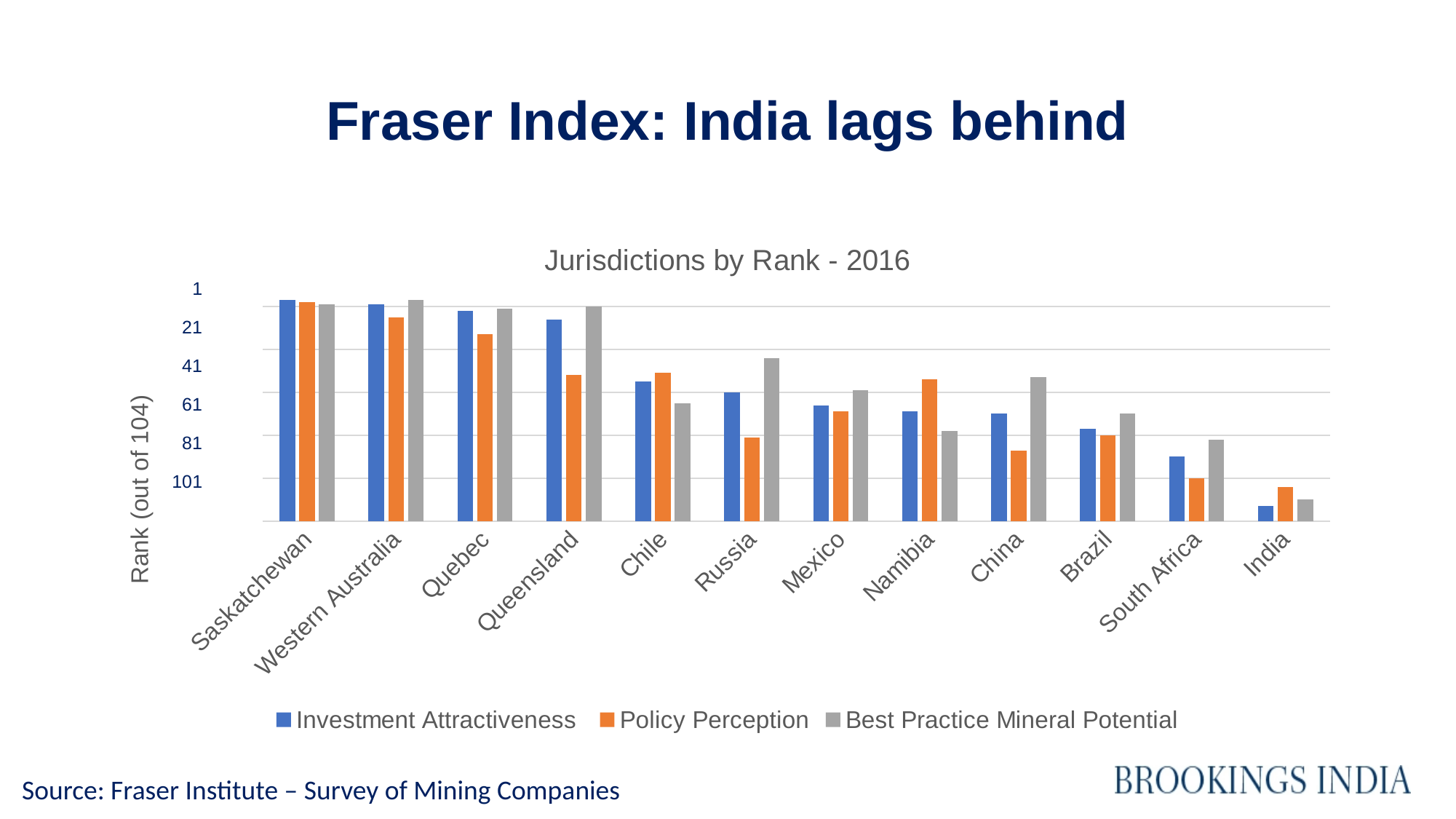
What kind of chart is shown on the slide? Bar chart Which jurisdiction has the worst (highest-numbered) Investment Attractiveness rank? India What is the title of the chart? Jurisdictions by Rank - 2016 Which jurisdiction has the best (lowest-numbered) Investment Attractiveness rank? Saskatchewan For Russia, which has the better (lower-numbered) rank: Policy Perception or Best Practice Mineral Potential? Best Practice Mineral Potential Is the Investment Attractiveness rank for India greater or less than 81? greater How many series does the chart's legend list? 3 Which jurisdiction has the worst (highest-numbered) Best Practice Mineral Potential rank? India Is the Investment Attractiveness rank for Saskatchewan greater or less than 21? less What is the label on the vertical axis of the chart? Rank (out of 104) How many jurisdictions are shown on the x axis of the chart? 12